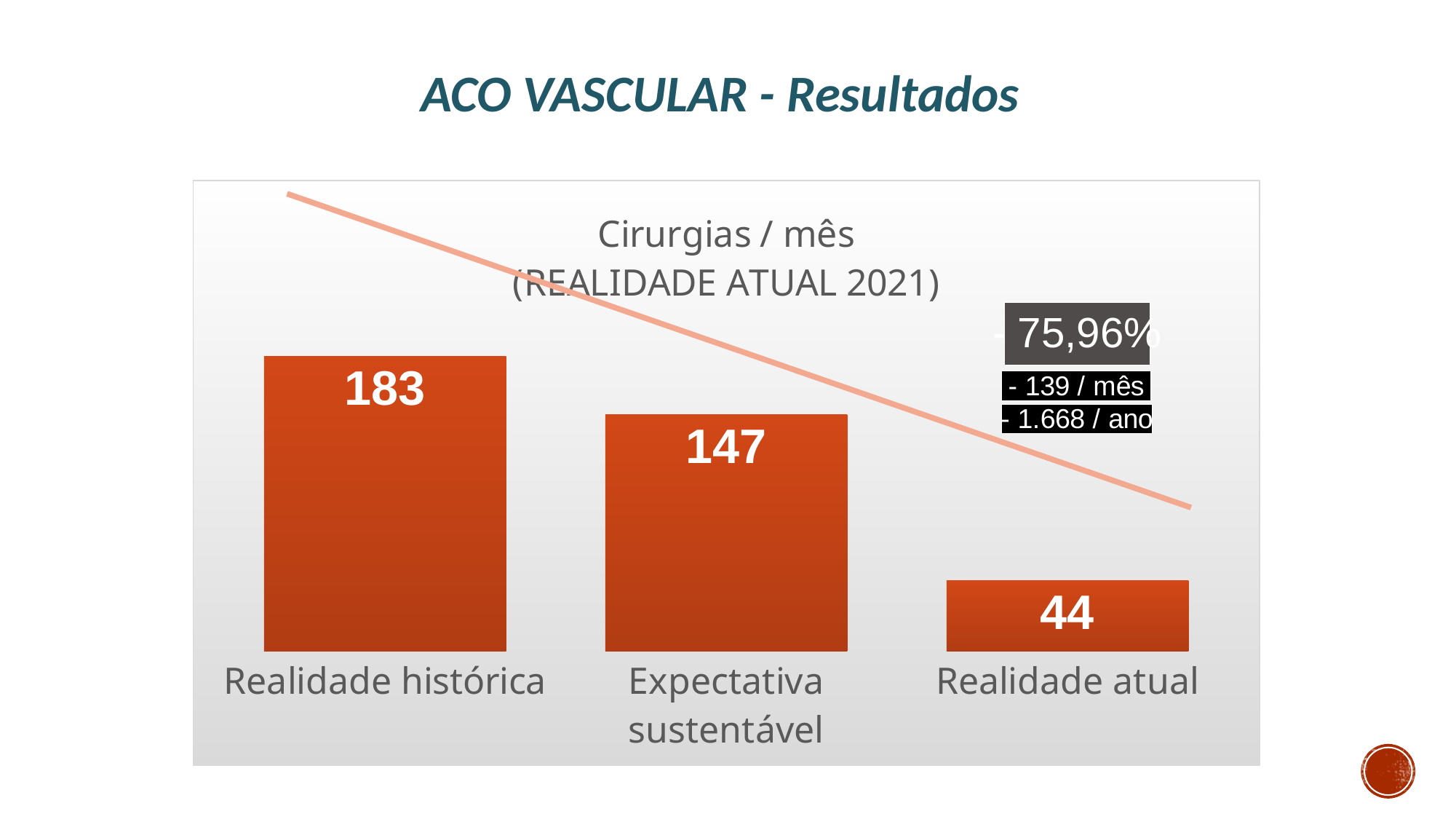
Do the values rise or fall from left to right across the categories? Fall What is the value for Realidade histórica? 183 What kind of chart is shown? Bar chart Which category has the highest value? Realidade histórica What is the difference between Realidade histórica and Expectativa sustentável? 36 Which is larger, Expectativa sustentável or Realidade atual? Expectativa sustentável What is the difference between Realidade histórica and Realidade atual? 139 What is the title of the chart? Cirurgias / mês (REALIDADE ATUAL 2021) How many categories are shown in the chart? 3 What is the value for Realidade atual? 44 Which category has the lowest value? Realidade atual What is the value for Expectativa sustentável? 147